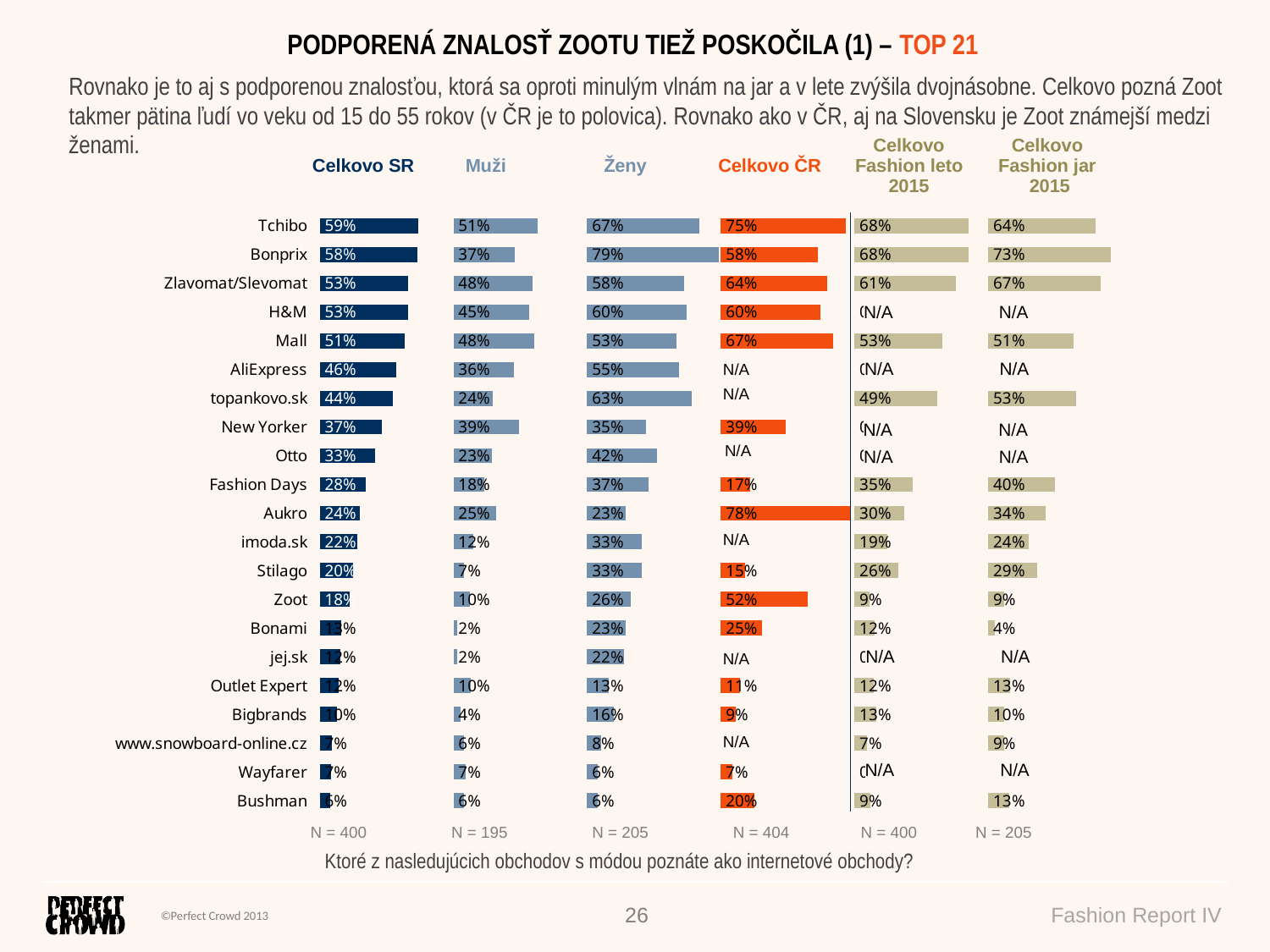
What is the sample size (N) shown for the Muži chart? N = 195 In the Ženy chart, which store has the highest value? Bonprix In the Celkovo ČR chart, what is the value for Zoot? 52% For Bonprix, which is larger: the Muži value or the Ženy value? Ženy What kind of chart is used on this slide? Bar chart In the Ženy chart, what is the value for Zoot? 26% In the Celkovo Fashion jar 2015 chart, what is the value for Bonprix? 73% How many stores are listed in the charts? 21 In the Celkovo SR chart, what is the value for Zoot? 18% In the Celkovo ČR chart, which store has the highest value? Aukro In the Celkovo SR chart, what is the value for Tchibo? 59% What is the difference between the Ženy and Muži values for Zoot? 16 percentage points